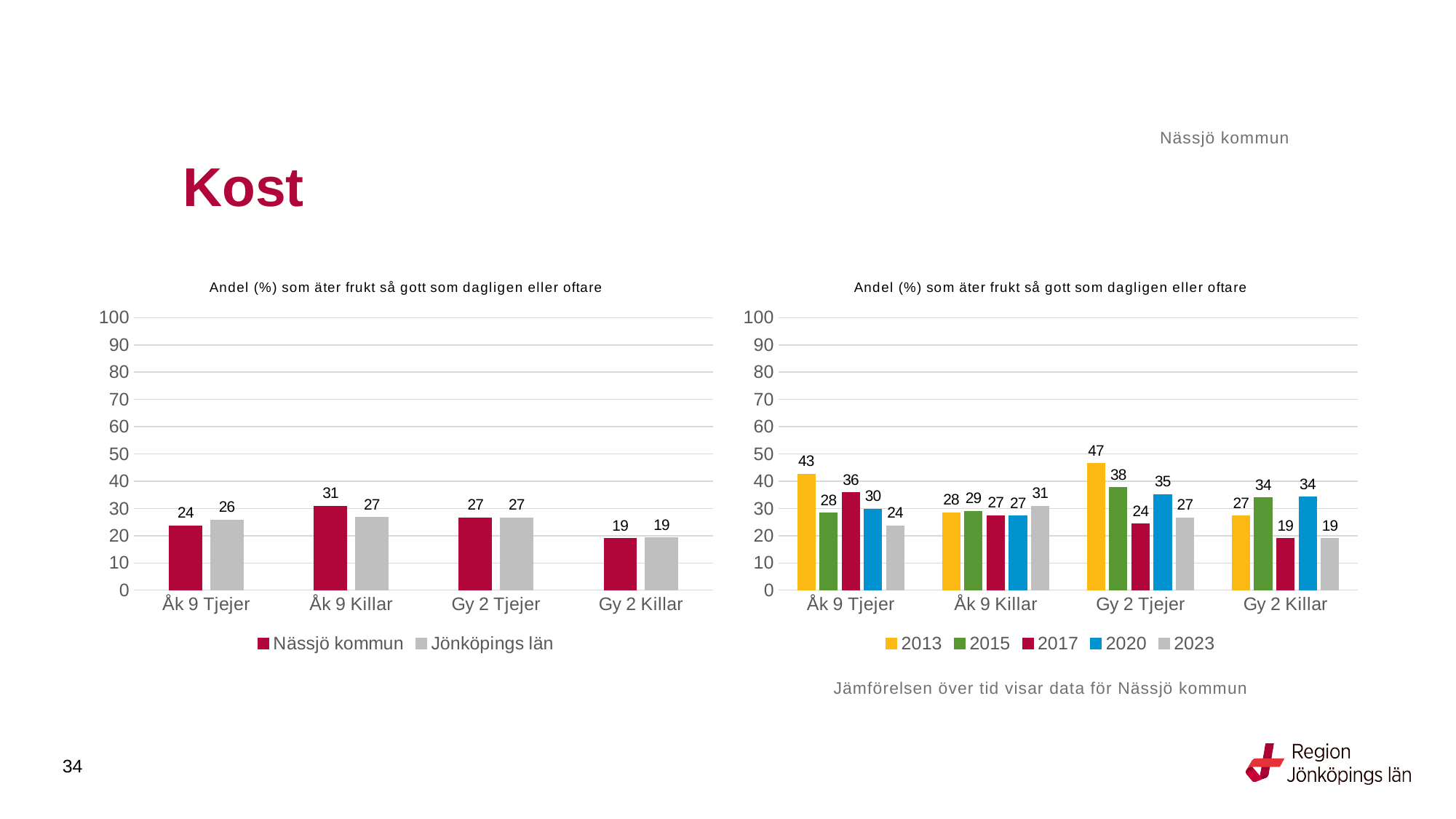
In the right chart, what is the value for 2023 for Åk 9 Killar? 31 What kind of chart is the right chart? Bar chart In the left chart, what is the value for Jönköpings län for Åk 9 Tjejer? 26 In the left chart, which category has the lowest value for Nässjö kommun? Gy 2 Killar In the right chart, how many series does the legend list? 5 In the left chart, how many series does the legend list? 2 In the left chart, what is the value for Nässjö kommun for Åk 9 Killar? 31 In the right chart, what is the value for 2013 for Gy 2 Tjejer? 47 In the right chart, which is larger for Gy 2 Killar: 2015 or 2017? 2015 In the left chart, what is the difference between Nässjö kommun and Jönköpings län for Åk 9 Killar? 4 In the right chart, what is the difference between the 2013 and 2023 values for Gy 2 Tjejer? 20 In the right chart, which year has the highest value for Åk 9 Tjejer? 2013